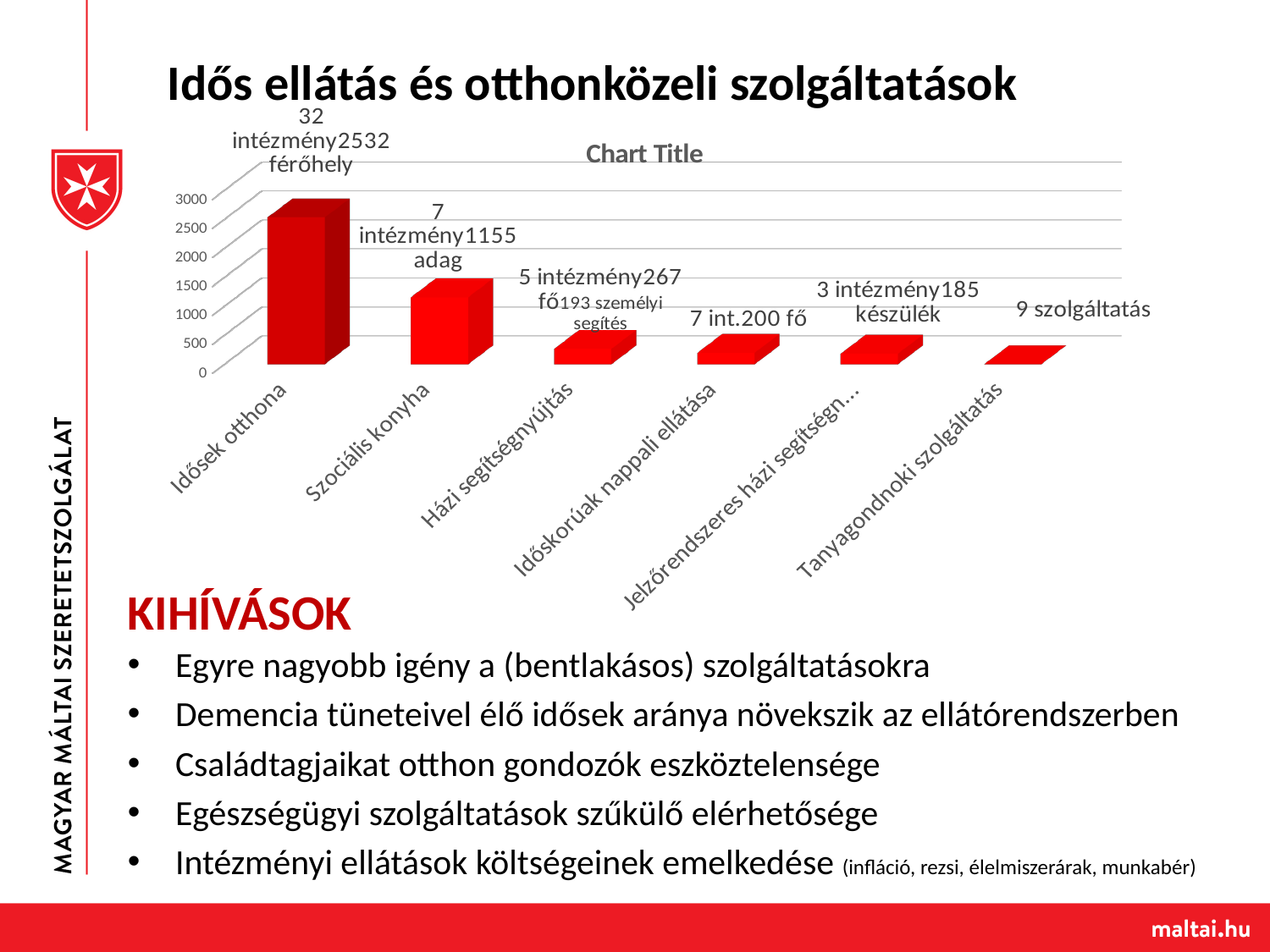
Do the bar values rise or fall from left to right along the x axis? fall Is the value for Idősek otthona greater or less than 2000? greater Which bar is taller, Idősek otthona or Szociális konyha? Idősek otthona Which category has the tallest bar in the chart? Idősek otthona What data label is printed above the bar for Időskorúak nappali ellátása? 7 int. 200 fő What data label is printed above the bar for Szociális konyha? 7 intézmény 1155 adag Which category has the shortest bar in the chart? Tanyagondnoki szolgáltatás What data label is printed above the bar for Idősek otthona? 32 intézmény 2532 férőhely How many categories are shown on the x axis of the chart? 6 What data label is printed above the bar for Tanyagondnoki szolgáltatás? 9 szolgáltatás What kind of chart is shown on the slide? bar chart Is the value for Szociális konyha greater or less than 1500? less